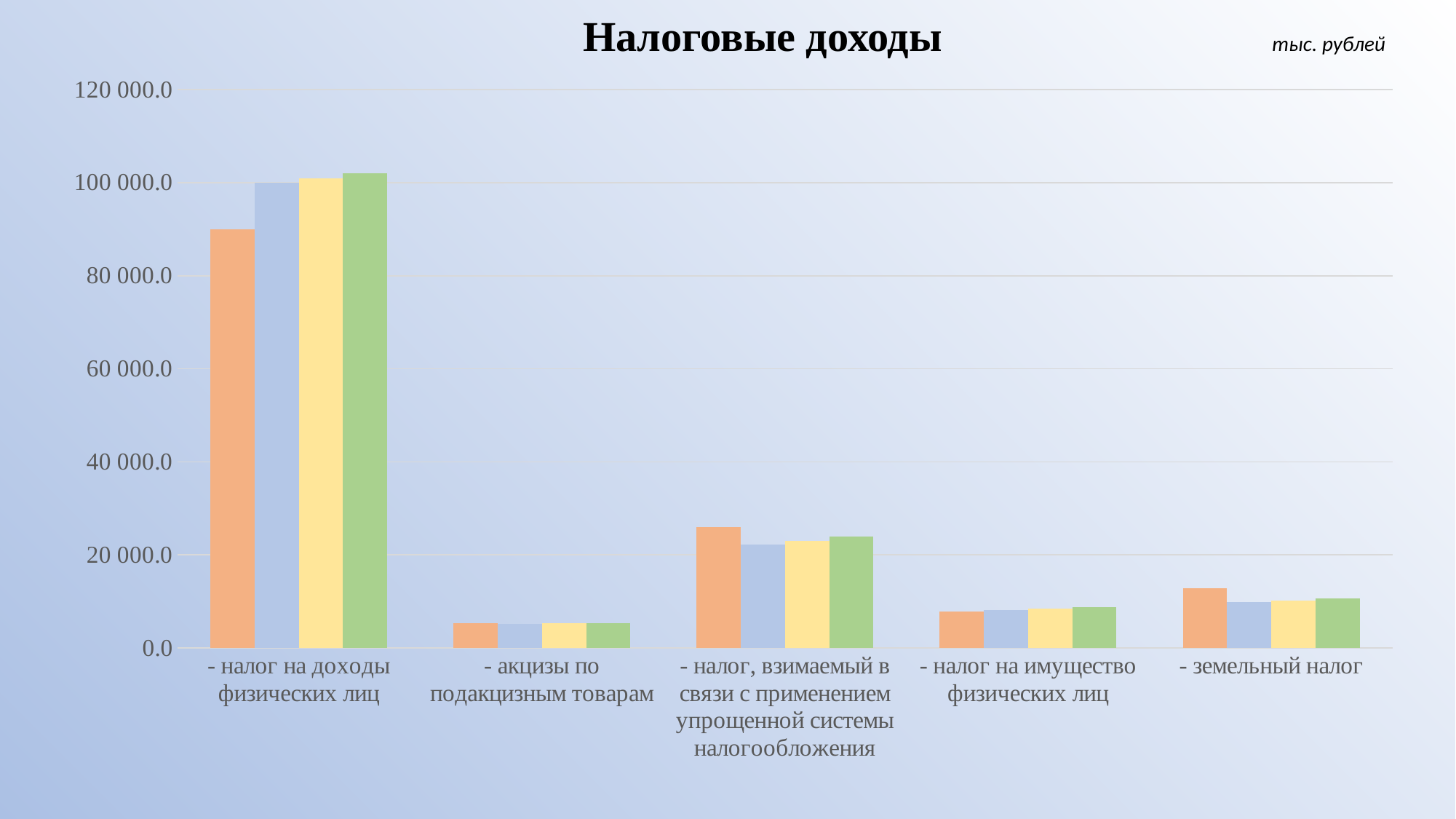
Is the value of the orange bar for '- налог, взимаемый в связи с применением упрощенной системы налогообложения' greater or less than 20 000.0? greater Is the value of the orange bar for '- налог на доходы физических лиц' greater or less than 80 000.0? greater How many bars are shown for each category in the chart? 4 What kind of chart is shown on the slide? bar chart Which category has the lowest values in the chart? - акцизы по подакцизным товарам Is the value of the orange bar for '- налог на доходы физических лиц' greater or less than 100 000.0? less What is the title of the chart? Налоговые доходы Which category has the highest values in the chart? - налог на доходы физических лиц How many categories are shown on the x axis of the chart? 5 Which category has larger values: '- налог на имущество физических лиц' or '- земельный налог'? - земельный налог In what units are the values of the chart given, according to the note in the top right corner? тыс. рублей